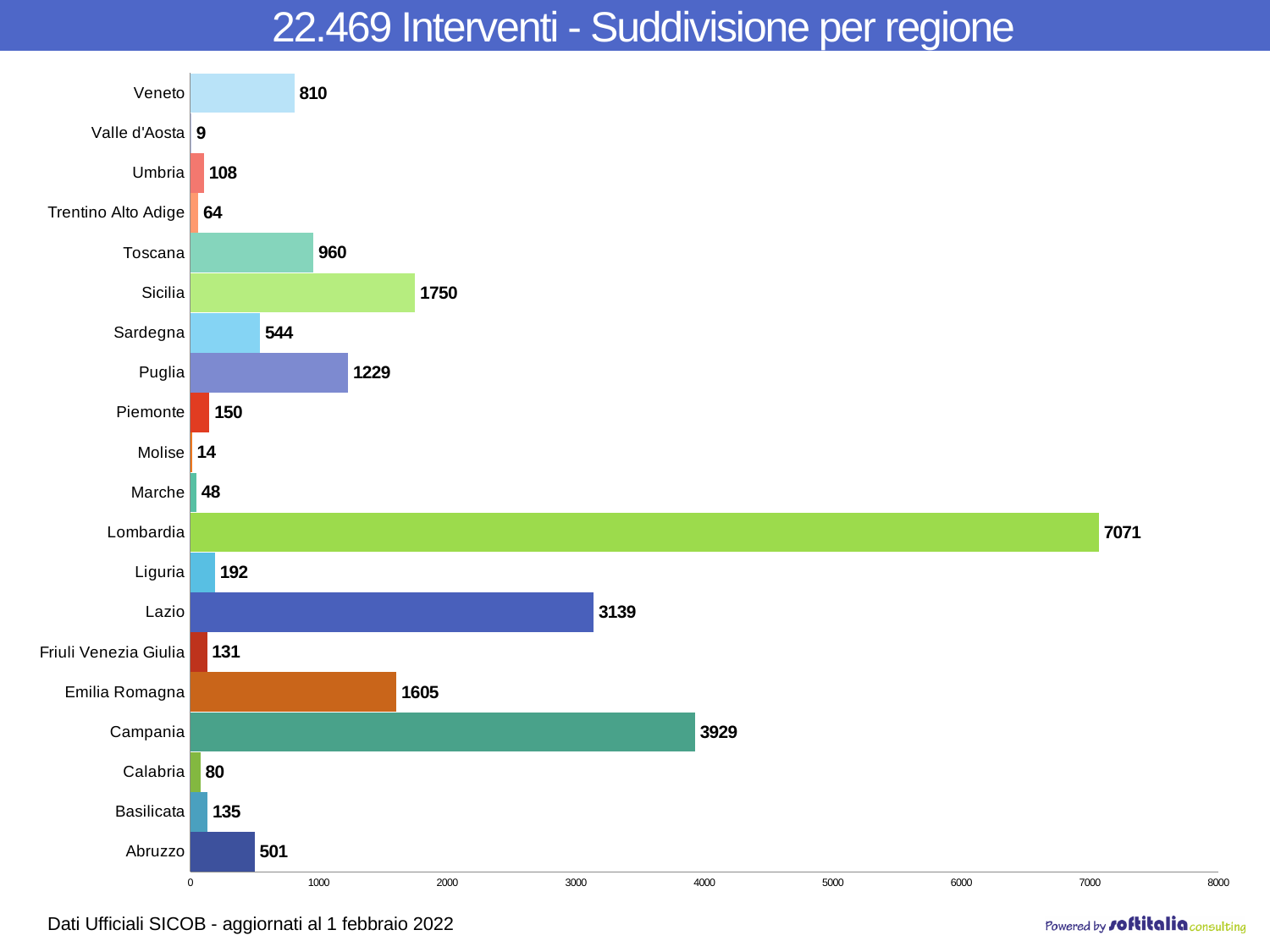
Which is larger, the value for Sicilia or the value for Emilia Romagna? Sicilia What is the value for Lombardia? 7071 What is the difference between the values for Lombardia and Lazio? 3932 How many regions are shown in the chart? 20 What is the difference between the values for Toscana and Veneto? 150 What is the value for Valle d'Aosta? 9 Which region has the lowest value? Valle d'Aosta What is the value for Campania? 3929 Is the value for Puglia greater or less than 1000? greater What kind of chart is shown on the slide? bar chart Which region has the highest value? Lombardia What is the title of the chart? 22.469 Interventi - Suddivisione per regione